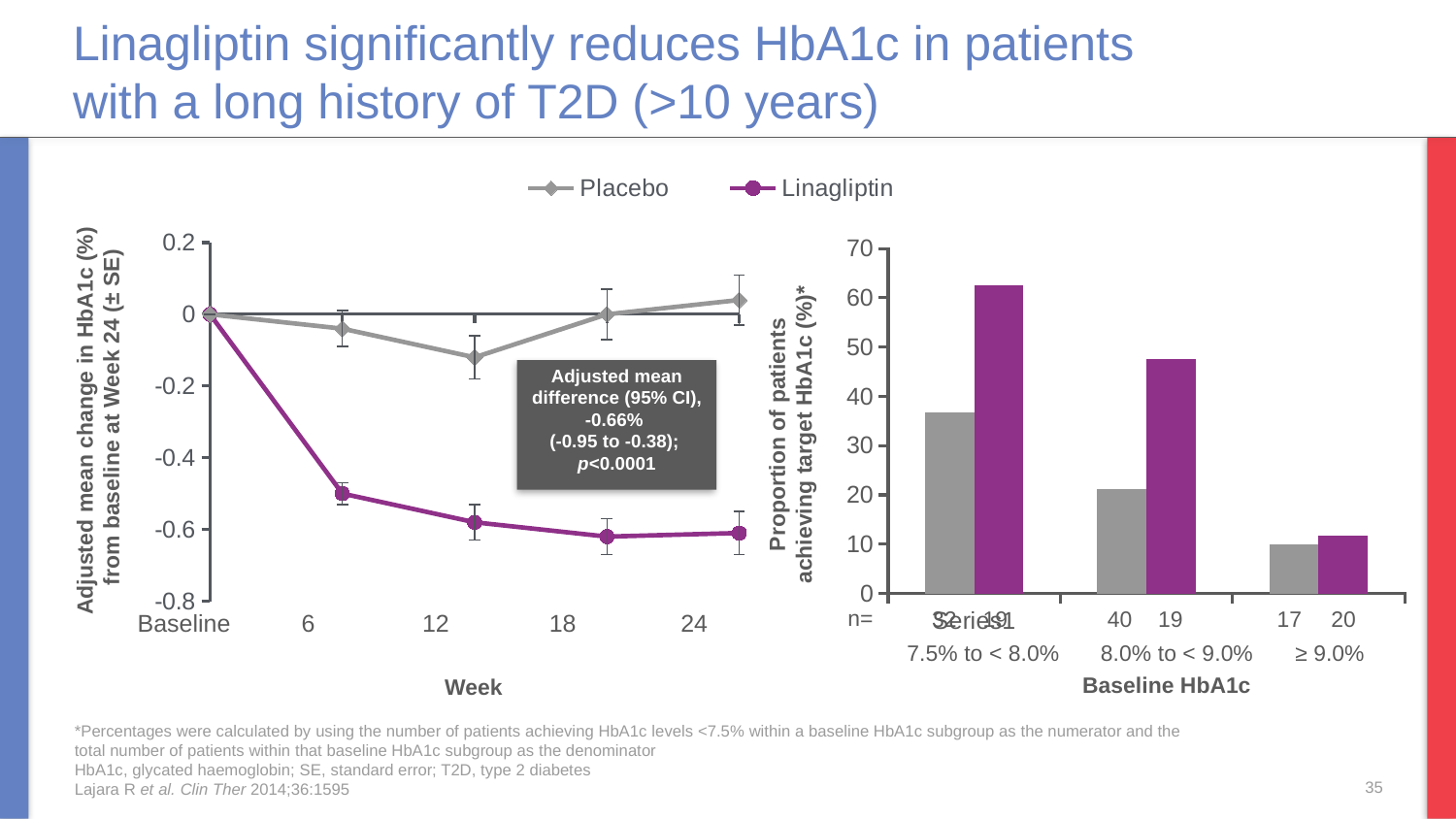
What kind of chart is the chart on the left of the slide? line chart How many series does the legend list? 2 In the bar chart on the right, how many baseline HbA1c categories are shown on the x axis? 3 In the line chart on the left, is the Placebo value at Week 24 greater or less than -0.2? greater In the bar chart on the right, is the Placebo value for the ≥ 9.0% category greater or less than 20? less What kind of chart is the chart on the right of the slide? bar chart In the bar chart on the right, for the 8.0% to < 9.0% category, which is larger: Placebo or Linagliptin? Linagliptin In the line chart on the left, does the Linagliptin line rise or fall from Baseline to Week 24? fall In the line chart on the left, how many time points are labelled on the Week axis? 5 In the line chart on the left, is the Linagliptin value at Week 24 greater or less than -0.4? less In the bar chart on the right, which baseline HbA1c category has the highest Linagliptin bar? 7.5% to < 8.0%